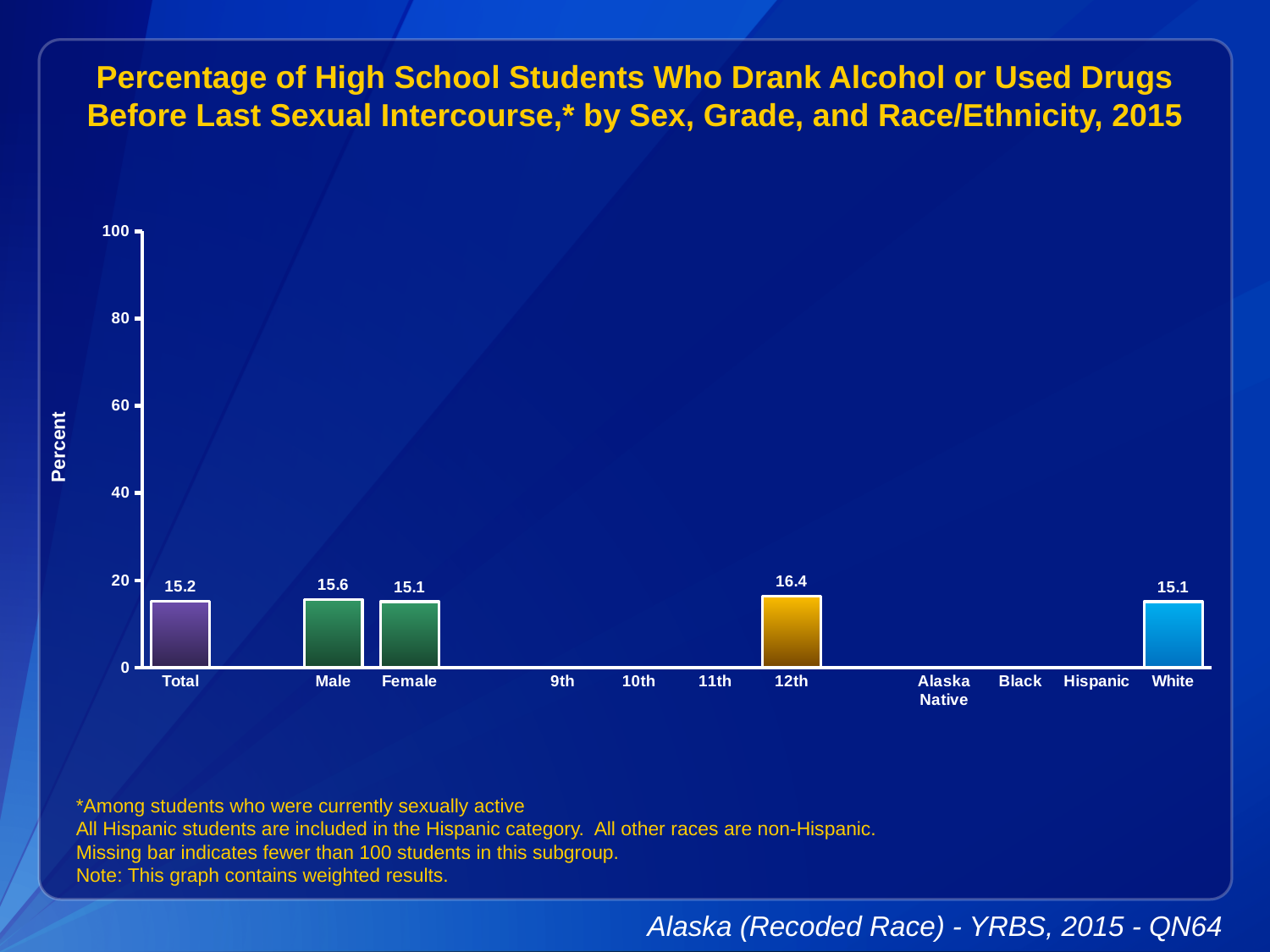
What is the difference between the Male and Female values? 0.5 Which category with a plotted bar has the highest value? 12th Which is larger, the value for Male or the value for Female? Male What kind of chart is shown on the slide? bar chart How many categories are labeled on the x axis? 11 What is the value for Total? 15.2 What is the value for White students? 15.1 What is the value for 12th grade? 16.4 How many categories have a bar plotted? 5 Is the value for 12th grade greater or less than 20? less What is the value for Male? 15.6 What is the label on the y axis? Percent